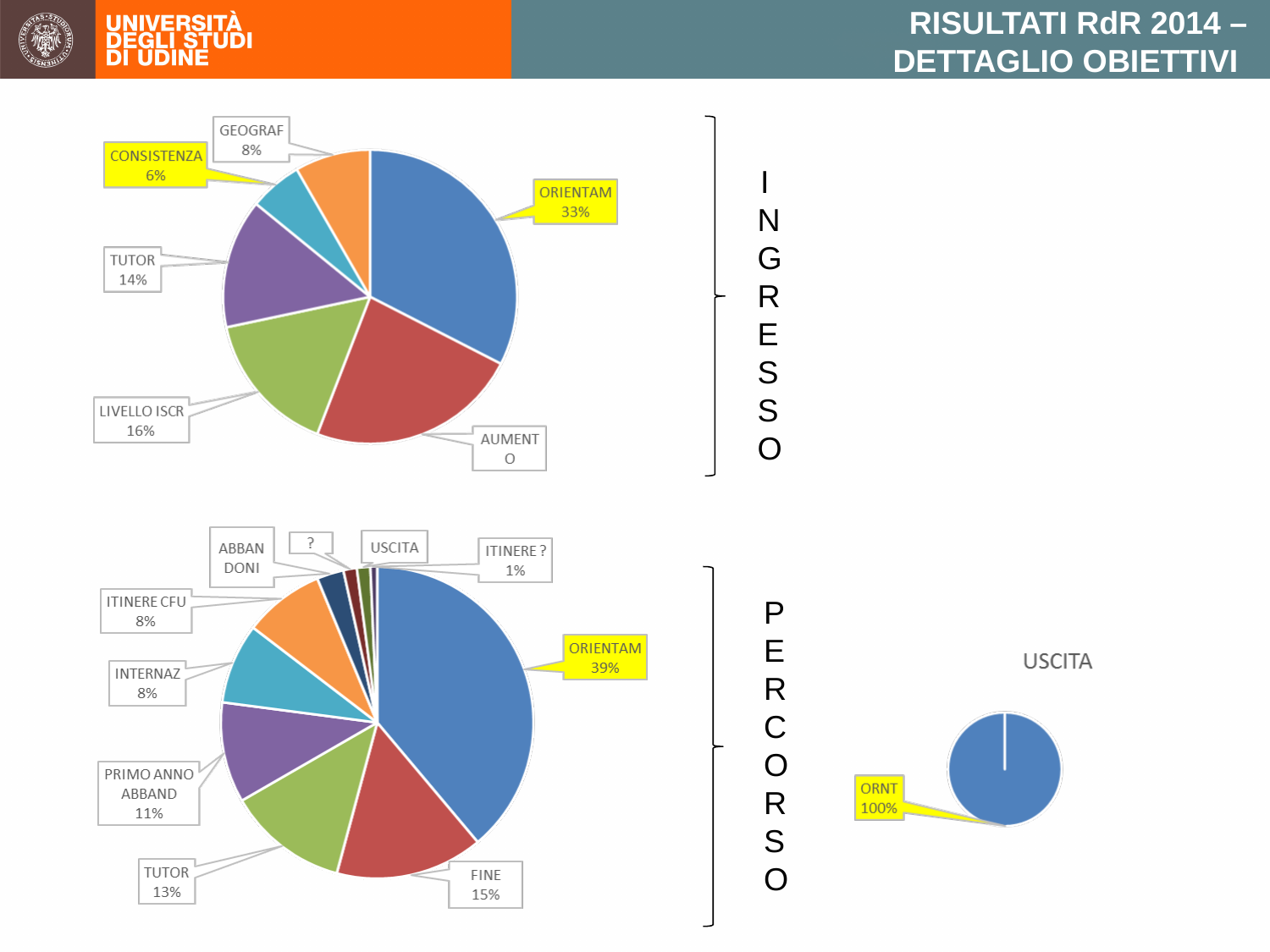
In the INGRESSO pie chart, what is the difference between the TUTOR share and the CONSISTENZA share? 8% In the PERCORSO pie chart, what percentage is shown for PRIMO ANNO ABBAND? 11% In the PERCORSO pie chart, what is the difference between the FINE share and the TUTOR share? 2% In the USCITA pie chart, what percentage is shown for ORNT? 100% In the PERCORSO pie chart, what percentage is shown for ORIENTAM? 39% In the INGRESSO pie chart, what percentage is shown for ORIENTAM? 33% In the PERCORSO pie chart, which is larger, INTERNAZ or ITINERE ? INTERNAZ What kind of chart is the USCITA chart? Pie chart In the INGRESSO pie chart, which is larger, GEOGRAF or CONSISTENZA? GEOGRAF In the INGRESSO pie chart, what percentage is shown for LIVELLO ISCR? 16% In the INGRESSO pie chart, which category has the largest share? ORIENTAM How many slices does the INGRESSO pie chart have? 6